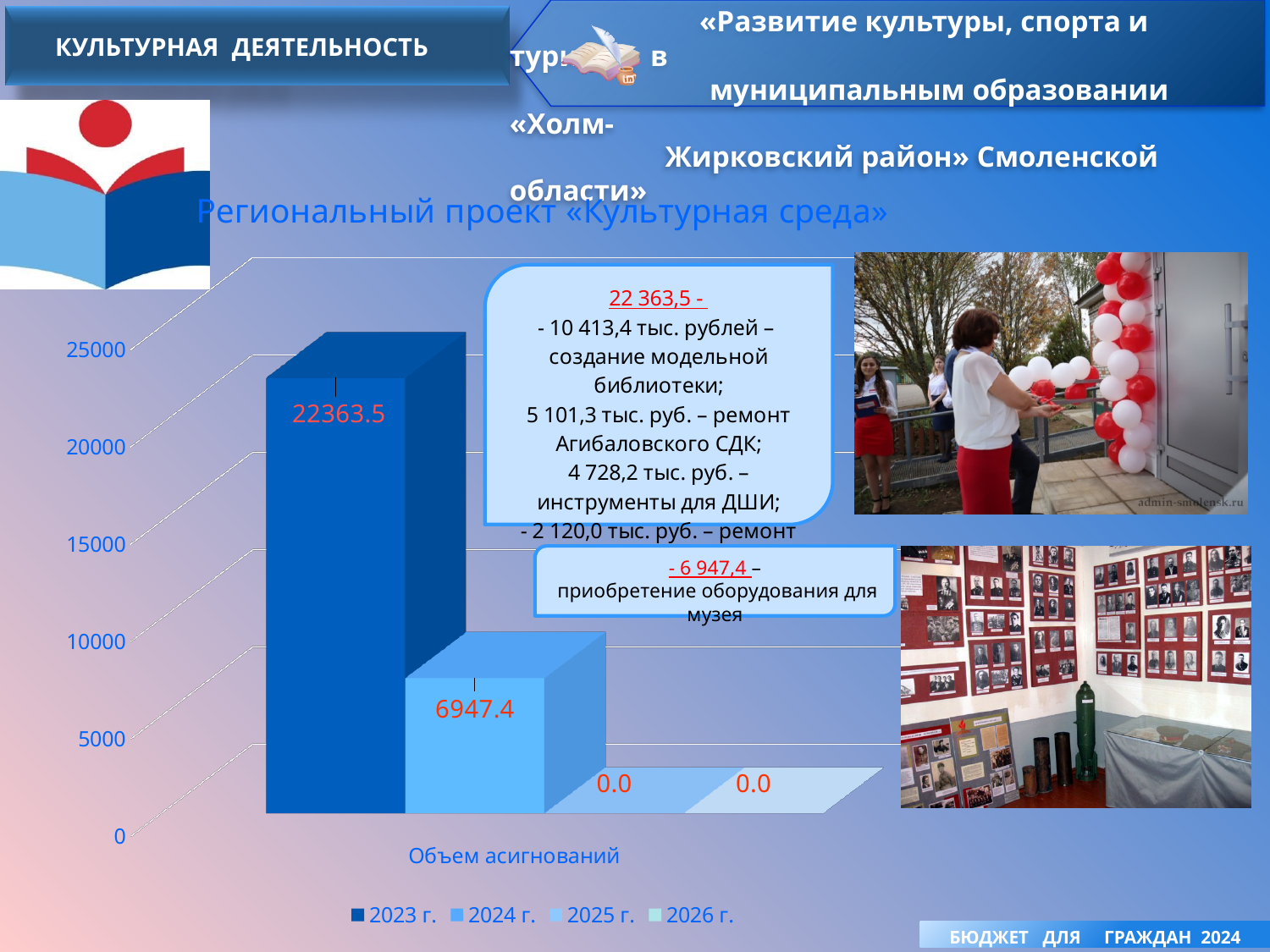
What is the value for 2024 г. in the chart? 6947.4 What is the difference between the values for 2023 г. and 2024 г.? 15416.1 Which year has the highest value in the chart? 2023 г. What is the category label shown on the x axis of the chart? Объем асигнований Which is larger, the value for 2023 г. or the value for 2024 г.? 2023 г. Is the value for 2024 г. greater or less than 10000? less What is the value for 2026 г. in the chart? 0.0 What kind of chart is shown on the slide? bar chart How many series does the chart legend list? 4 What is the value for 2025 г. in the chart? 0.0 Is the value for 2023 г. greater or less than 20000? greater What is the value for 2023 г. in the chart? 22363.5